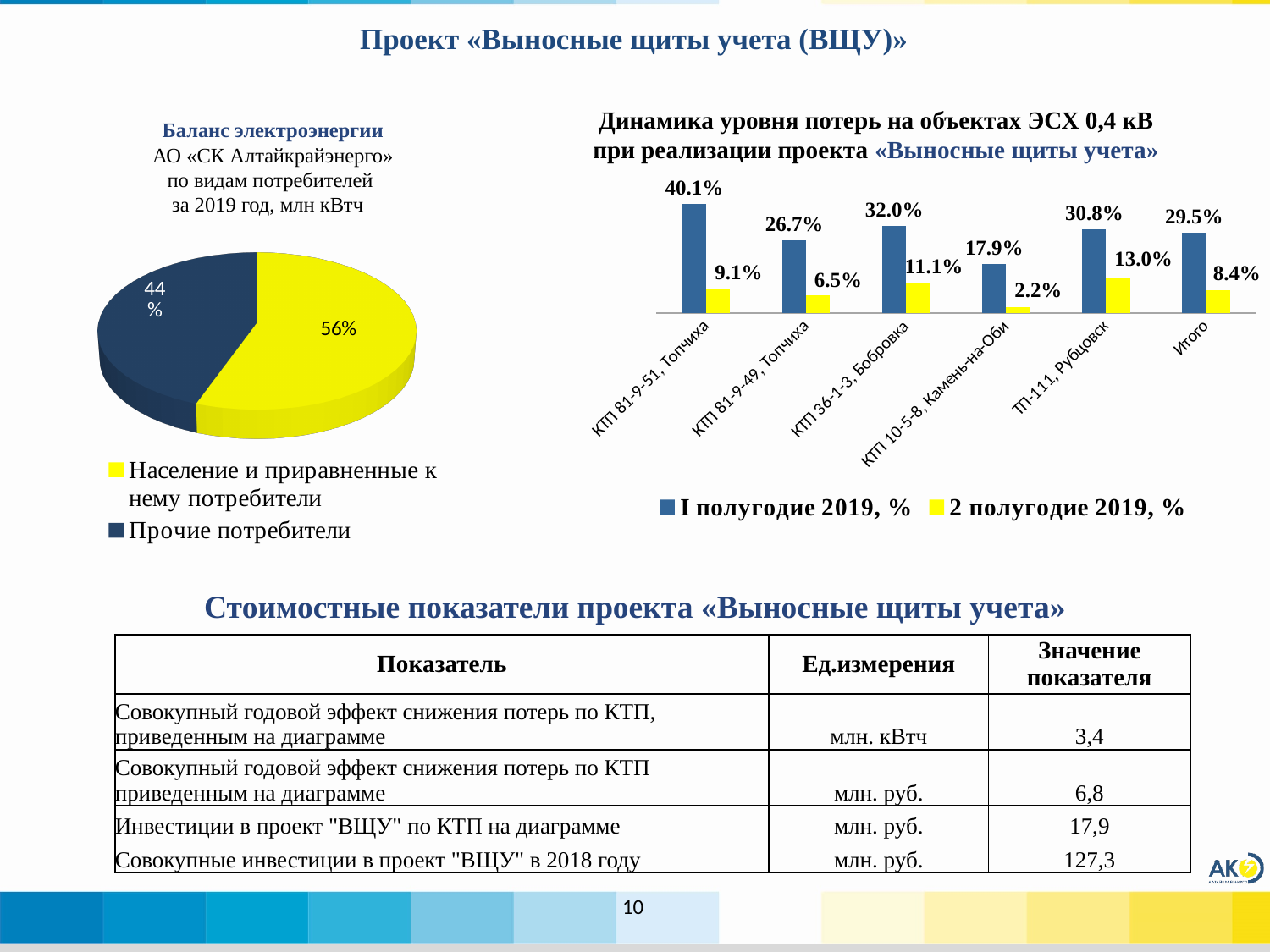
In the bar chart «Динамика уровня потерь на объектах ЭСХ 0,4 кВ», which category has the lowest value for «2 полугодие 2019, %»? КТП 10-5-8, Камень-на-Оби What kind of chart is the chart on the right of the slide, «Динамика уровня потерь на объектах ЭСХ 0,4 кВ»? Bar chart In the pie chart on the left, what share is shown for «Население и приравненные к нему потребители»? 56% How many series does the legend of the bar chart «Динамика уровня потерь на объектах ЭСХ 0,4 кВ» list? 2 In the bar chart «Динамика уровня потерь на объектах ЭСХ 0,4 кВ», which is larger for КТП 36-1-3, Бобровка: the «I полугодие 2019, %» value or the «2 полугодие 2019, %» value? I полугодие 2019, % In the bar chart «Динамика уровня потерь на объектах ЭСХ 0,4 кВ», what is the value for «I полугодие 2019, %» at КТП 81-9-51, Толчиха? 40.1% In the pie chart on the left, what share is shown for «Прочие потребители»? 44% In the bar chart «Динамика уровня потерь на объектах ЭСХ 0,4 кВ», what is the difference between the «I полугодие 2019, %» and «2 полугодие 2019, %» values for Итого? 21.1% What kind of chart is the chart on the left of the slide? Pie chart How many categories are shown on the x axis of the bar chart «Динамика уровня потерь на объектах ЭСХ 0,4 кВ»? 6 In the bar chart «Динамика уровня потерь на объектах ЭСХ 0,4 кВ», what is the value for «2 полугодие 2019, %» at ТП-111, Рубцовск? 13.0% In the bar chart «Динамика уровня потерь на объектах ЭСХ 0,4 кВ», which category has the highest value for «I полугодие 2019, %»? КТП 81-9-51, Топчиха